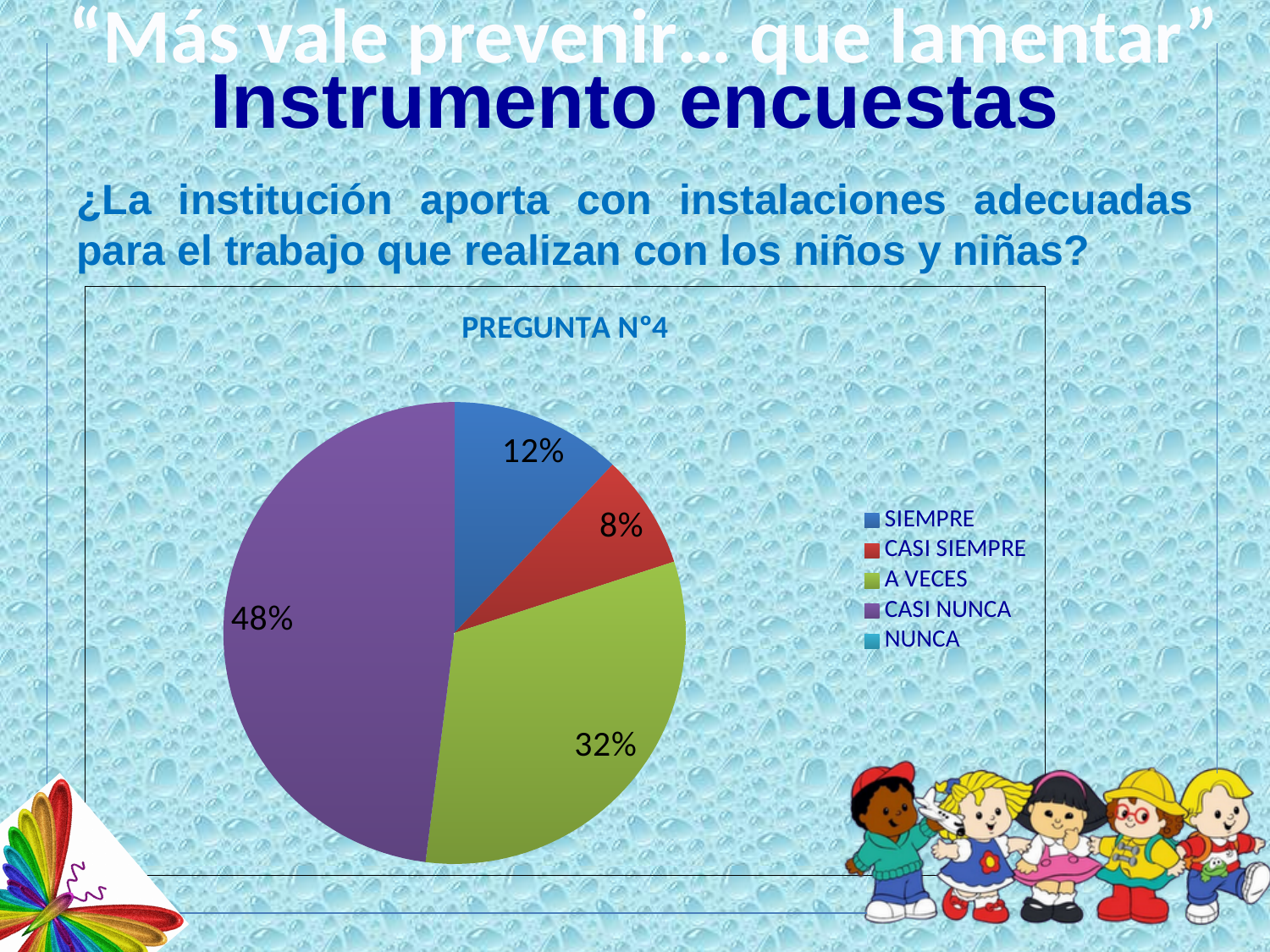
What percentage does the CASI NUNCA slice represent? 48% What kind of chart is shown on the slide? pie chart Which of the slices shown in the pie is the smallest? CASI SIEMPRE What is the difference in percentage points between the CASI NUNCA slice and the A VECES slice? 16% What percentage does the CASI SIEMPRE slice represent? 8% What is the title of the chart? PREGUNTA N°4 What percentage does the A VECES slice represent? 32% What is the difference in percentage points between the A VECES slice and the SIEMPRE slice? 20% What percentage does the SIEMPRE slice represent? 12% Which is larger, the SIEMPRE slice or the CASI SIEMPRE slice? SIEMPRE How many entries does the legend list? 5 Which category has the largest slice of the pie? CASI NUNCA